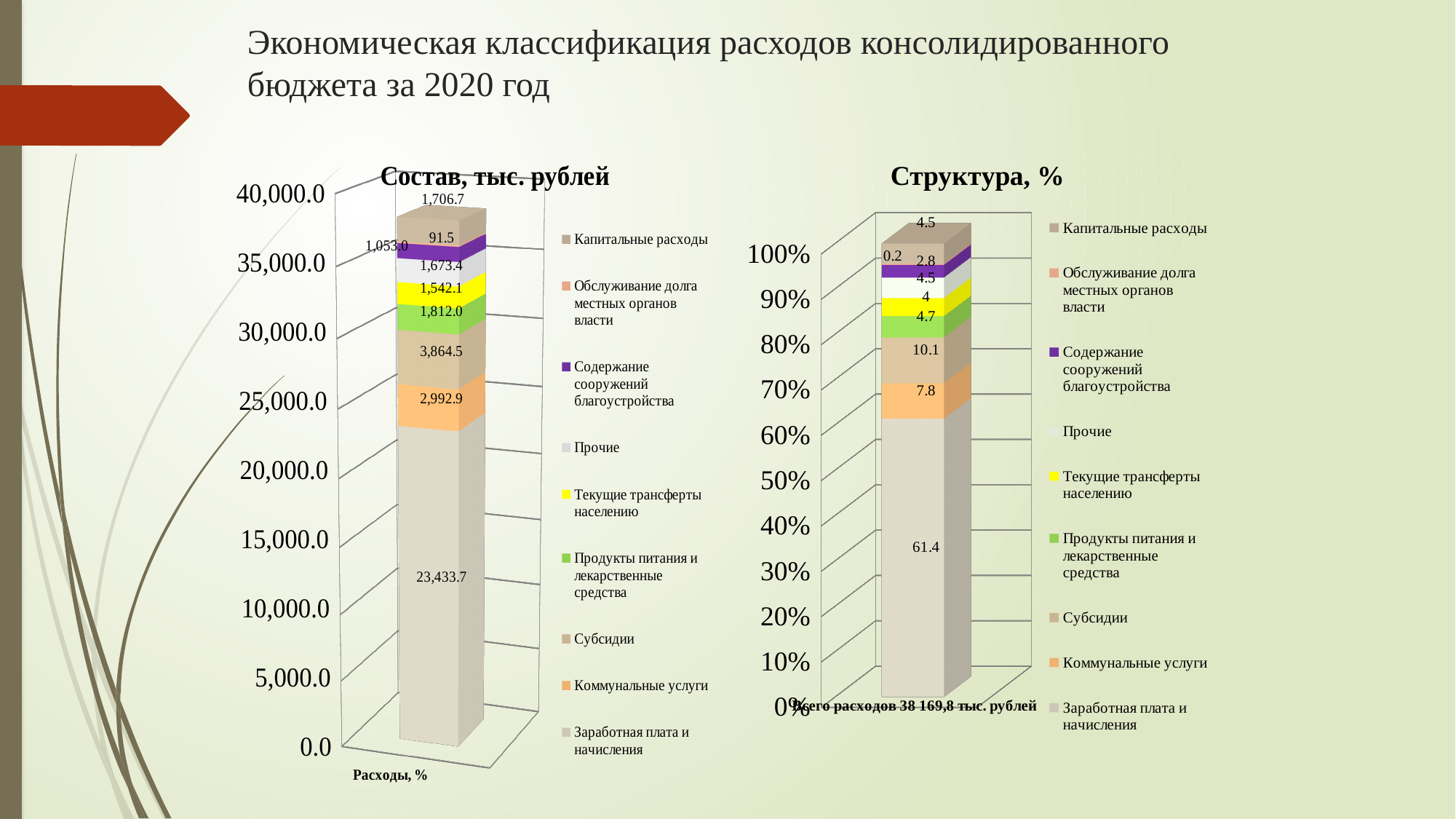
In the 'Состав, тыс. рублей' chart, what is the difference between 'Субсидии' and 'Коммунальные услуги'? 871.6 How many series does the legend of the 'Структура, %' chart list? 9 What kind of chart is the 'Состав, тыс. рублей' chart? bar chart In the 'Состав, тыс. рублей' chart, which category has the largest value? Заработная плата и начисления In the 'Состав, тыс. рублей' chart, what is the value for 'Капитальные расходы'? 1,706.7 In the 'Структура, %' chart, what is the value for 'Заработная плата и начисления'? 61.4 In the 'Состав, тыс. рублей' chart, what is the value for 'Заработная плата и начисления'? 23,433.7 In the 'Структура, %' chart, which category has the smallest value? Обслуживание долга местных органов власти In the 'Состав, тыс. рублей' chart, which is larger: 'Продукты питания и лекарственные средства' or 'Текущие трансферты населению'? Продукты питания и лекарственные средства According to the slide, what is the total of the stacked bar in the 'Состав, тыс. рублей' chart (всего расходов)? 38 169,8 тыс. рублей In the 'Состав, тыс. рублей' chart, what is the value for 'Субсидии'? 3,864.5 In the 'Структура, %' chart, what is the value for 'Субсидии'? 10.1